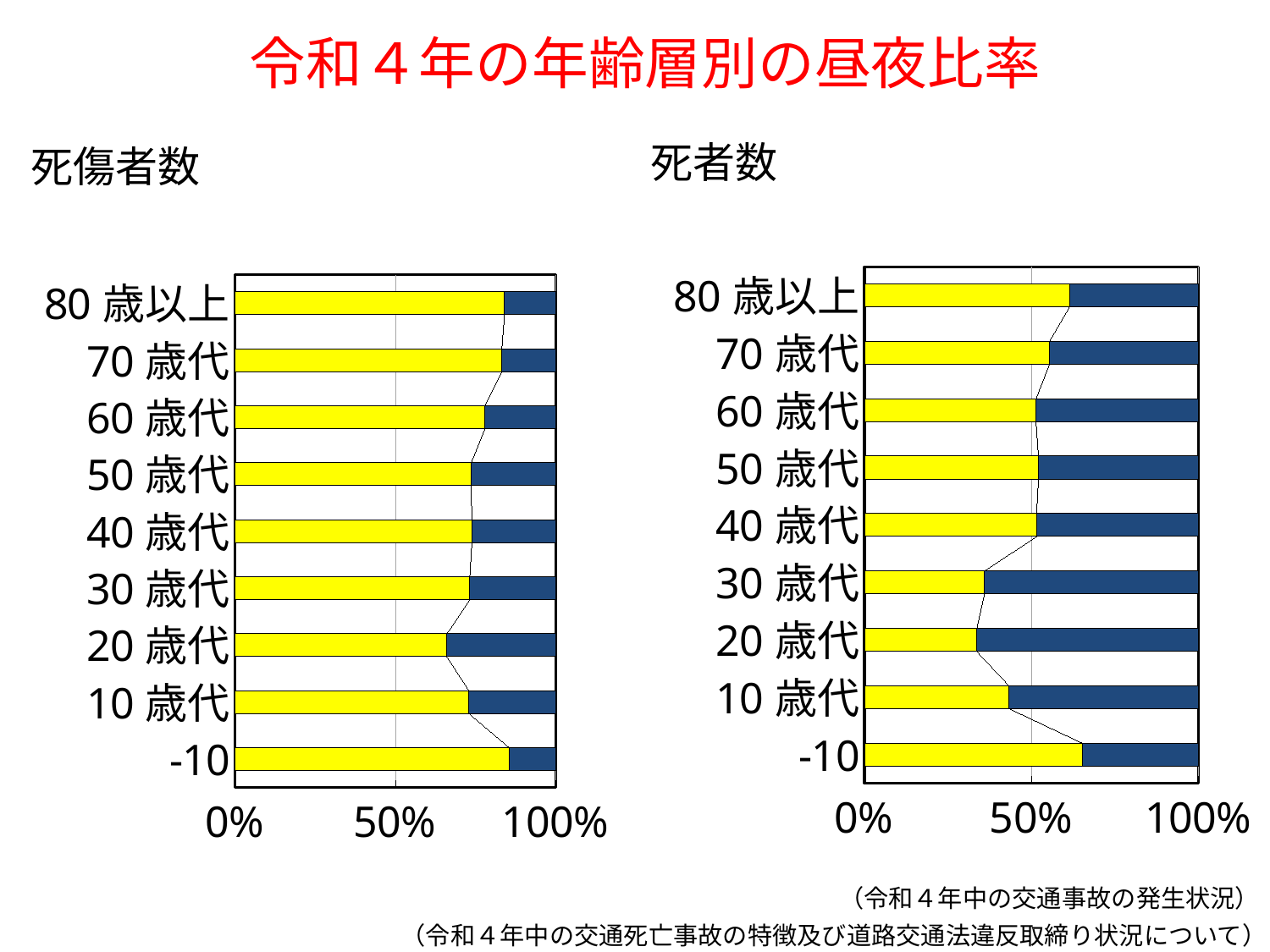
What is the maximum value shown on the x axis of the 死者数 chart on the right? 100% In the 死者数 chart on the right, is the yellow portion for 30歳代 greater or less than 50%? less In the 死傷者数 chart on the left, which has the larger yellow portion, -10 or 20歳代? -10 In the 死者数 chart on the right, is the yellow portion for 80歳以上 greater or less than 50%? greater What is the title of the slide? 令和４年の年齢層別の昼夜比率 In the 死傷者数 chart on the left, which age category has the smallest yellow portion? 20歳代 How many age categories are shown in the 死者数 chart on the right? 9 How many age categories are shown in the 死傷者数 chart on the left? 9 In the 死者数 chart on the right, is the yellow portion for 10歳代 greater or less than 50%? less In the 死者数 chart on the right, which has the larger yellow portion, 80歳以上 or 20歳代? 80歳以上 What kind of chart is the 死傷者数 chart on the left? bar chart